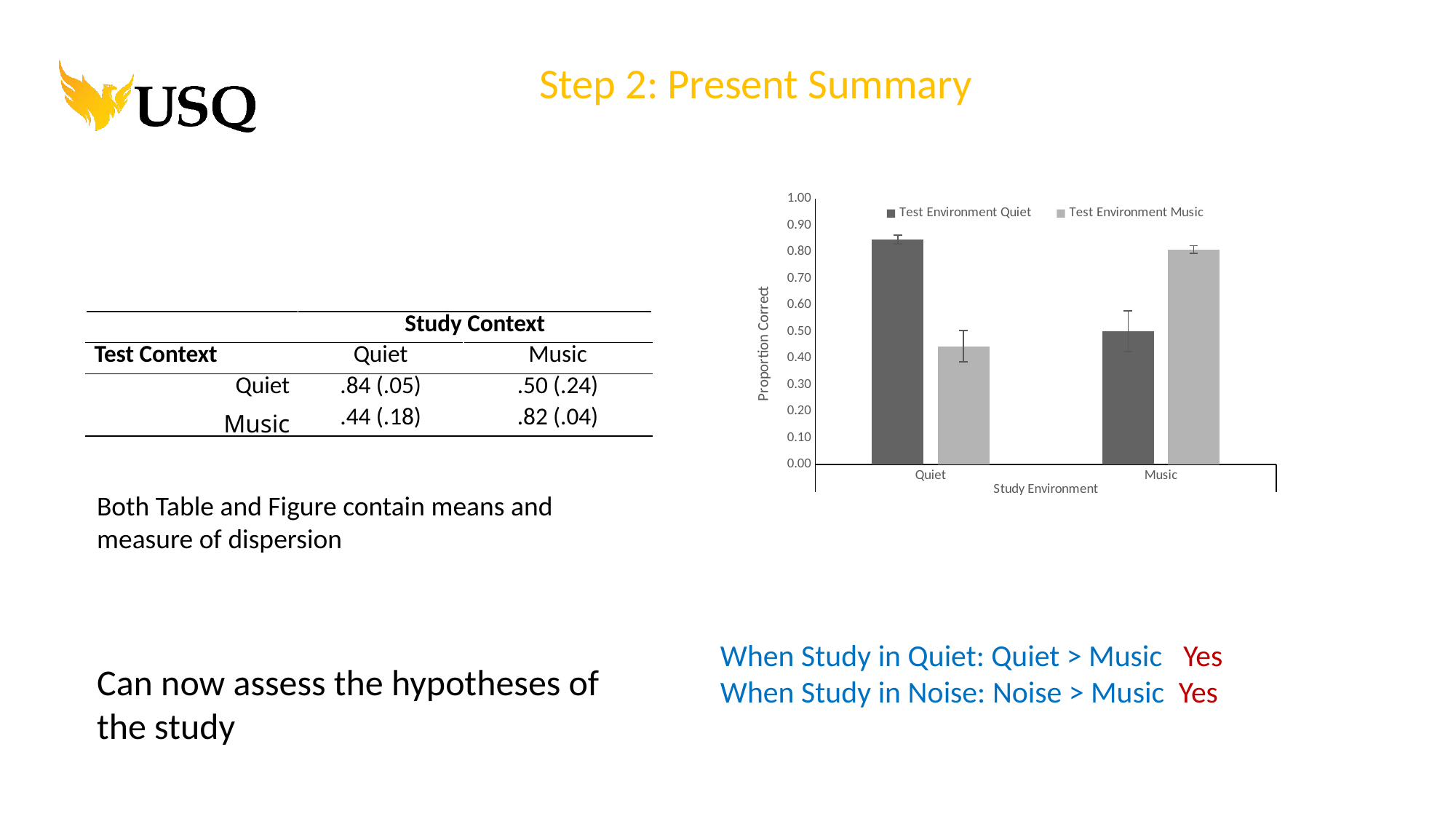
What is the label of the y axis of the chart? Proportion Correct What kind of chart is shown on the slide? bar chart Is the value for Test Environment Quiet in the Quiet study environment greater or less than 0.80? greater What is the label of the x axis of the chart? Study Environment How many series does the chart legend list? 2 Is the value for Test Environment Music in the Music study environment greater or less than 0.70? greater Is the value for Test Environment Quiet in the Music study environment greater or less than 0.60? less Which bar in the chart is the lowest? Test Environment Music in the Quiet study environment In the Music study environment, which series has the larger value: Test Environment Quiet or Test Environment Music? Test Environment Music How many study environment categories are shown on the x axis of the chart? 2 In the Quiet study environment, which series has the larger value: Test Environment Quiet or Test Environment Music? Test Environment Quiet